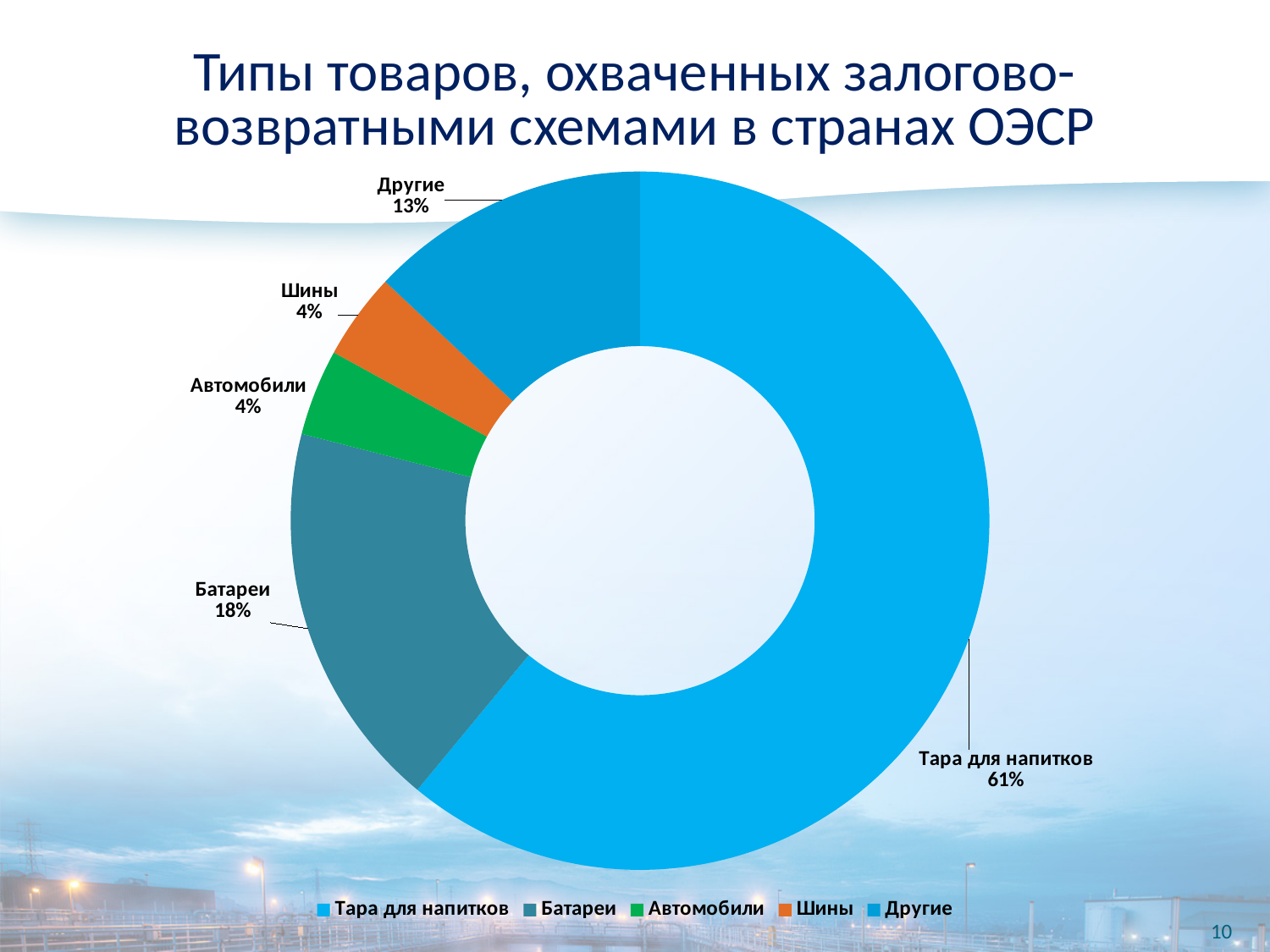
What is the difference between the shares of Батареи and Другие? 5% What colour is the Шины slice? Orange What is the value shown for Батареи? 18% Which category has the largest share? Тара для напитков How many categories are shown in the chart? 5 What share of the chart does Тара для напитков account for? 61% Which is larger, the share of Батареи or the share of Другие? Батареи What is the difference between the shares of Тара для напитков and Батареи? 43% What is the value shown for Другие? 13% What is the value shown for Шины? 4% What is the title of the chart on the slide? Типы товаров, охваченных залогово-возвратными схемами в странах ОЭСР What kind of chart is shown on the slide? Doughnut (pie) chart